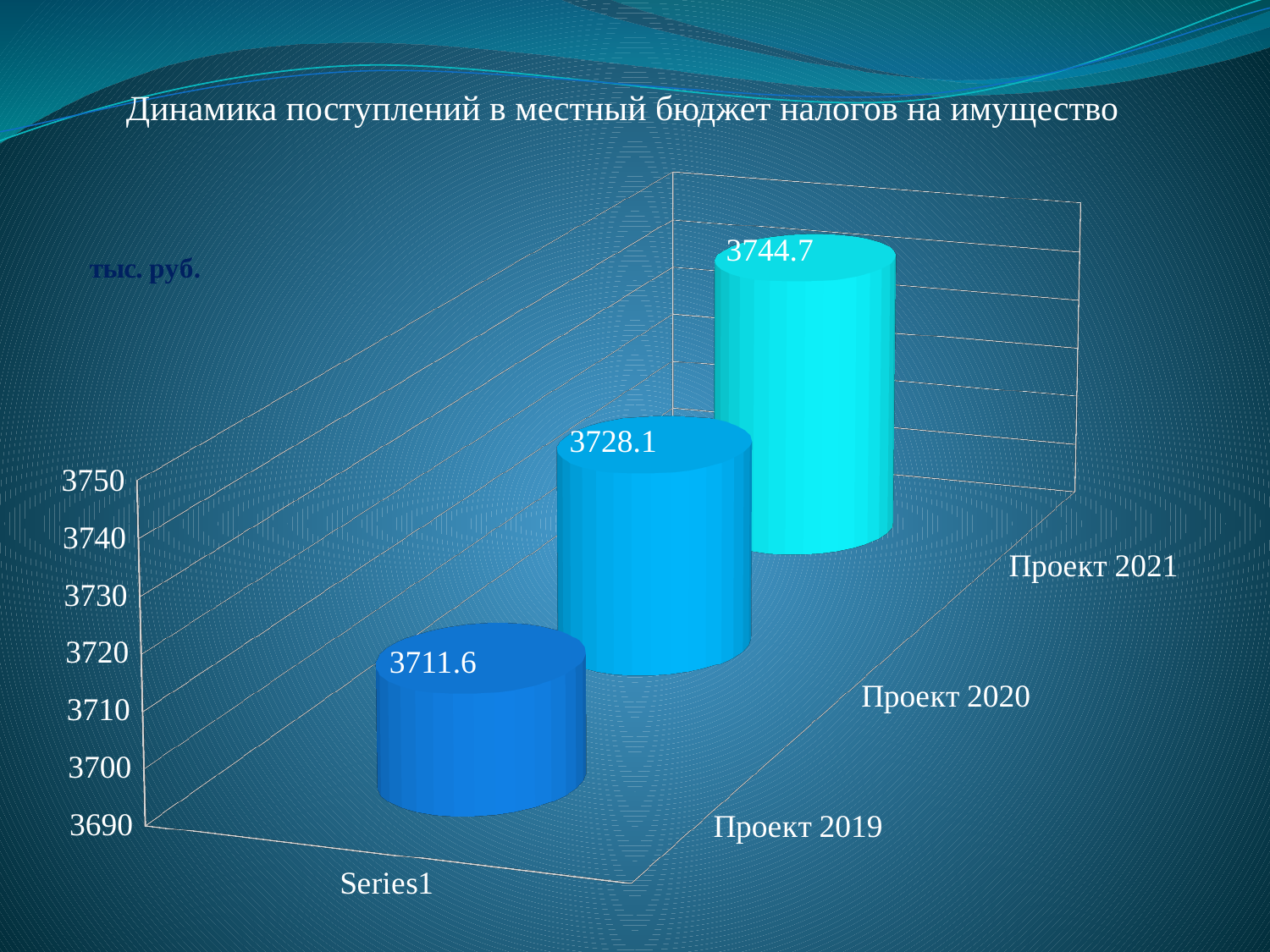
What is the difference between the values for Проект 2020 and Проект 2019? 16.5 What is the difference between the values for Проект 2021 and Проект 2019? 33.1 Which category has the highest value? Проект 2021 What is the value for Проект 2020? 3728.1 Do the values rise or fall from Проект 2019 to Проект 2021? rise Which is larger, the value for Проект 2020 or Проект 2021? Проект 2021 How many categories are shown in the chart? 3 Which category has the lowest value? Проект 2019 What is the value for Проект 2019? 3711.6 What kind of chart is this? bar chart What is the title of the chart? Динамика поступлений в местный бюджет налогов на имущество What is the value for Проект 2021? 3744.7